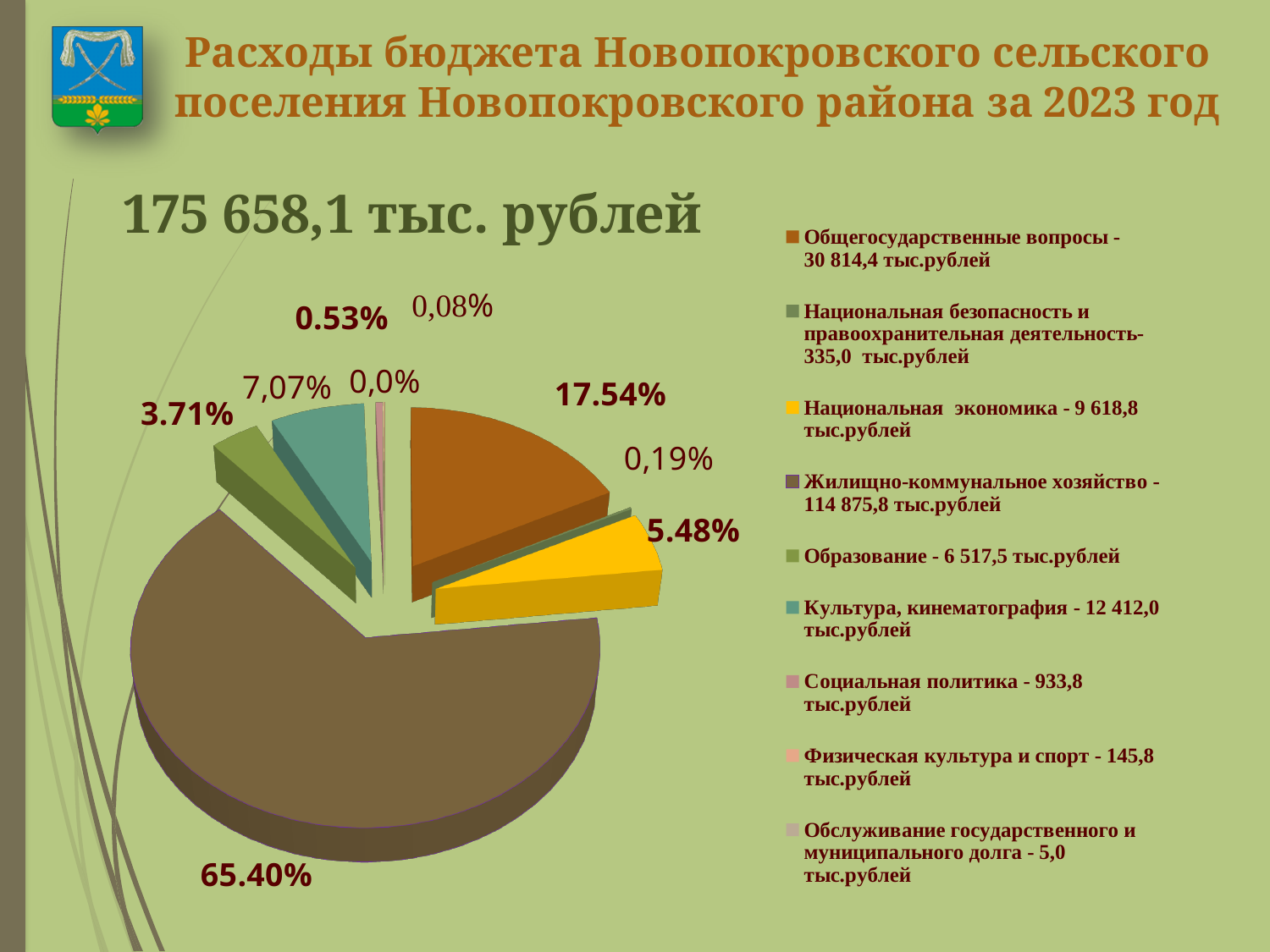
What total expenditure amount is shown above the chart? 175 658,1 тыс. рублей What share of the pie does Жилищно-коммунальное хозяйство take? 65.40% What is the expenditure amount for Общегосударственные вопросы? 30 814,4 тыс.рублей What is the difference between the expenditure on Общегосударственные вопросы and on Национальная экономика? 21 195,6 тыс.рублей What share of the pie does Национальная экономика take? 5.48% Which category accounts for the largest share of the budget expenditures? Жилищно-коммунальное хозяйство Which category has the smallest expenditure amount? Обслуживание государственного и муниципального долга What share of the pie does Образование take? 3.71% What is the expenditure amount for Культура, кинематография? 12 412,0 тыс.рублей What kind of chart is shown on the slide? Pie chart Which is larger: the expenditure on Образование or on Культура, кинематография? Культура, кинематография How many expenditure categories does the legend list? 9